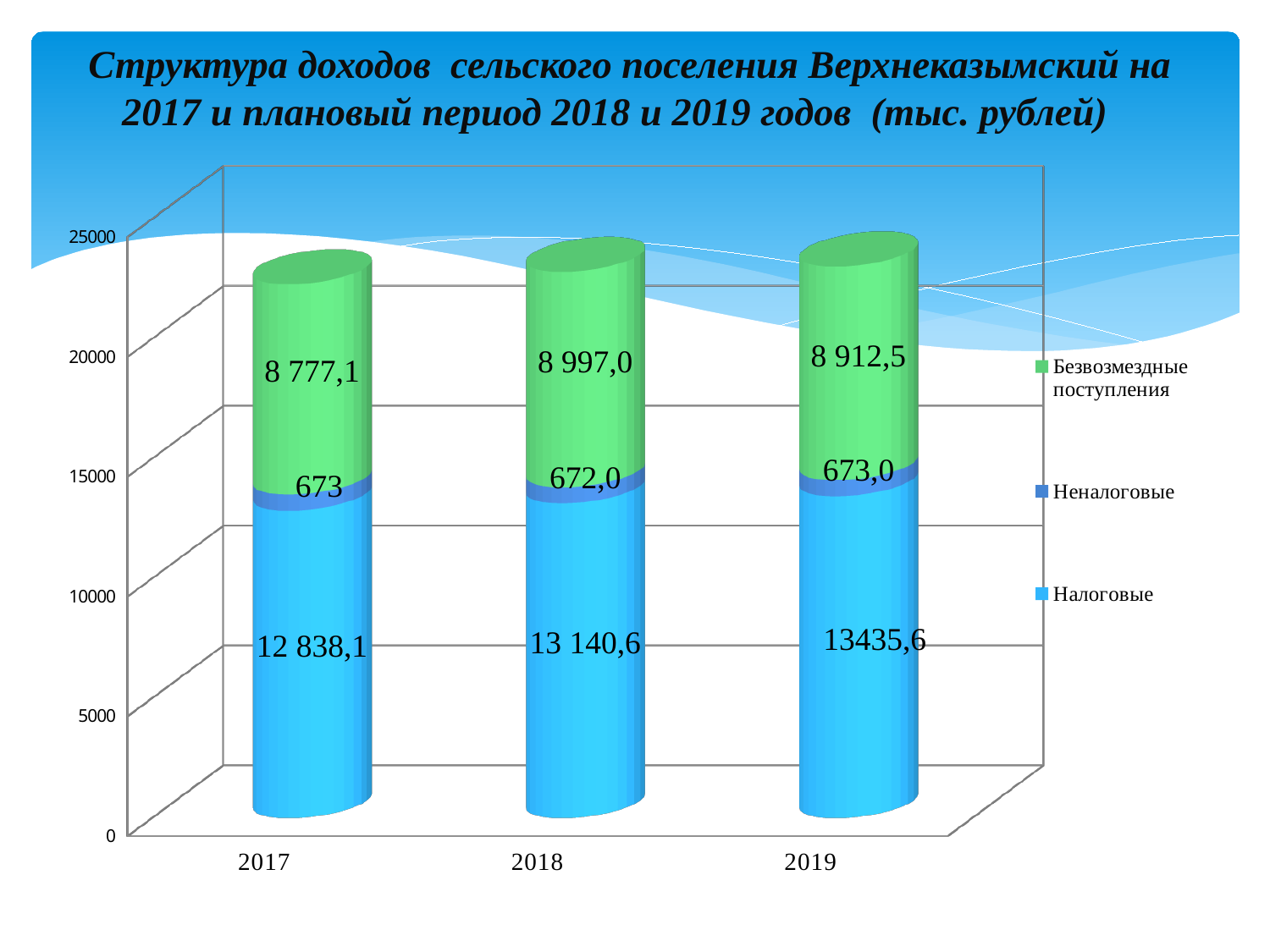
Which is larger: Безвозмездные поступления in 2018 or in 2019? 2018 How many series does the legend list? 3 How many years are shown on the x axis? 3 What is the difference between the Налоговые values for 2018 and 2017? 302,5 What is the total of the stacked bar for 2017? 22 288,2 In which year is the Безвозмездные поступления value the lowest? 2017 What kind of chart is shown on the slide? Stacked bar chart What is the value of Неналоговые for 2019? 673,0 In which year is the Налоговые value the highest? 2019 What is the value of Налоговые for 2017? 12 838,1 Do the Налоговые values rise or fall from 2017 to 2019? Rise What is the value of Безвозмездные поступления for 2018? 8 997,0